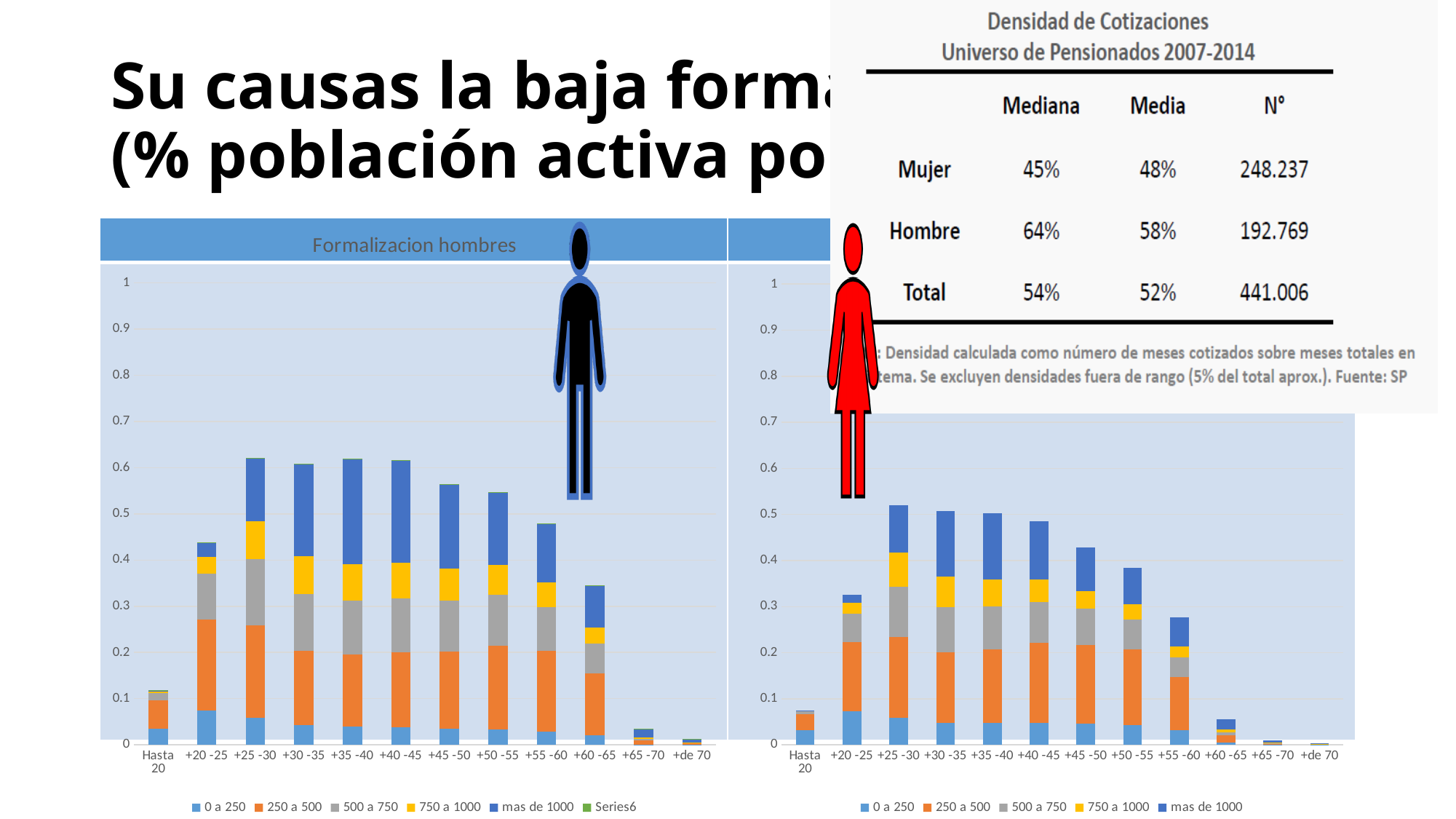
In the left chart "Formalizacion hombres", is the total value for Hasta 20 greater or less than 0.2? less How many series does the legend of the left chart "Formalizacion hombres" list? 6 What kind of chart is the left chart titled "Formalizacion hombres"? Stacked bar chart In the right chart, which age category has the lowest total bar? +de 70 In the right chart, is the total value for +20 -25 greater or less than 0.3? greater How many age categories are shown on the x axis of the left chart "Formalizacion hombres"? 12 In the left chart "Formalizacion hombres", which has the larger total bar: +25 -30 or +60 -65? +25 -30 In the left chart "Formalizacion hombres", is the total value for +25 -30 greater or less than 0.5? greater In the right chart, do the total bar values rise or fall from +50 -55 to +de 70? fall How many series does the legend of the right chart list? 5 In the left chart "Formalizacion hombres", which age category has the lowest total bar? +de 70 What is the first legend entry of the left chart "Formalizacion hombres"? 0 a 250